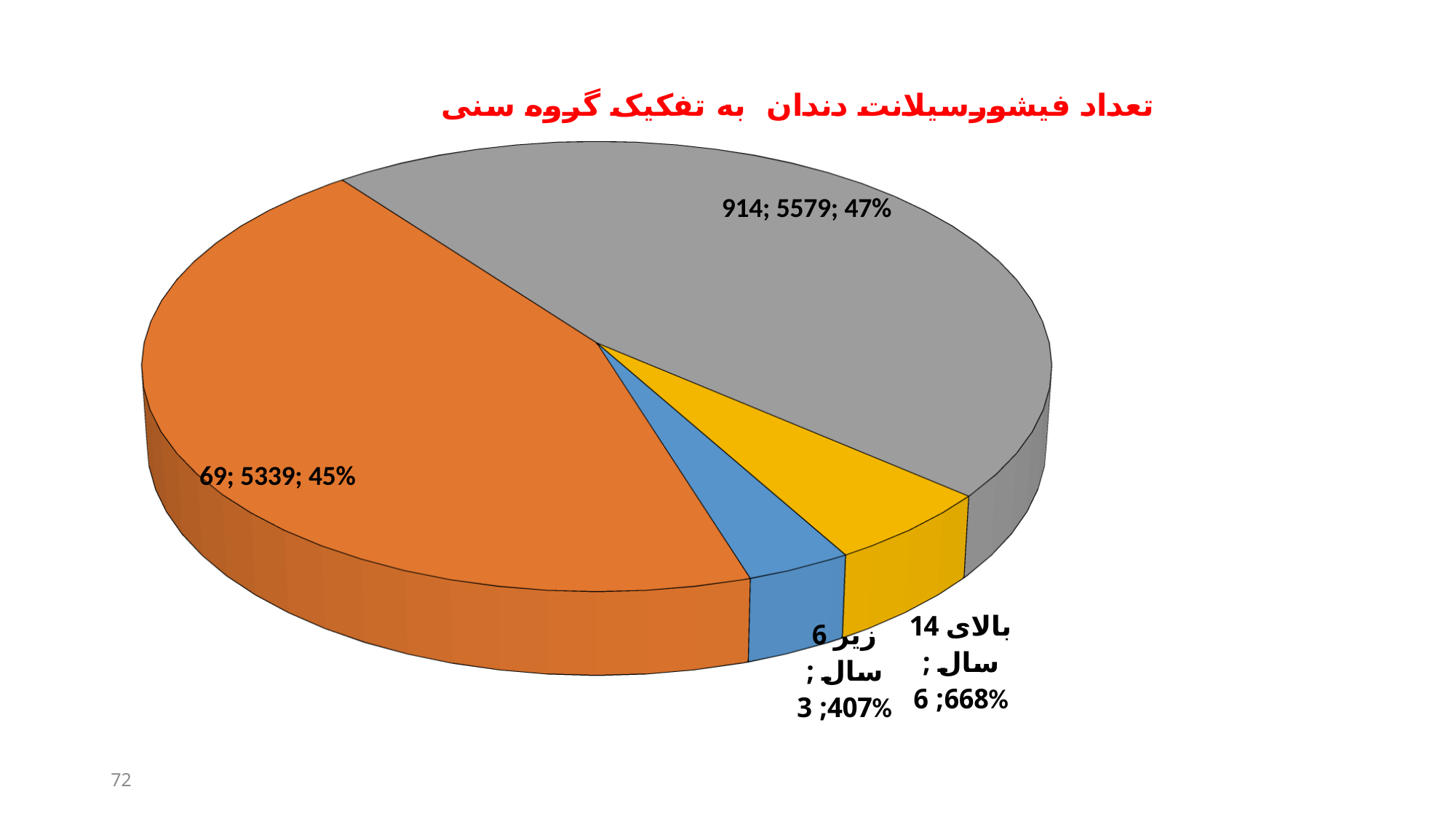
What kind of chart is shown on the slide? pie chart What value is labelled on the gray slice of the pie? 5579 What is the value shown for the 'بالای 14 سال' slice? 668 How many slices does the pie chart have? 4 What share of the pie does the 'زیر 6 سال' slice represent? 3% What percentage does the largest slice of the pie represent? 47% What is the value shown for the 'زیر 6 سال' slice? 407 What percentage is labelled on the orange slice of the pie? 45% Which is larger, the value for 'بالای 14 سال' or the value for 'زیر 6 سال'? بالای 14 سال What is the difference between the value of the gray slice (5579) and the orange slice (5339)? 240 What share of the pie does the 'بالای 14 سال' slice represent? 6% Which slice is the smallest in the pie chart? زیر 6 سال